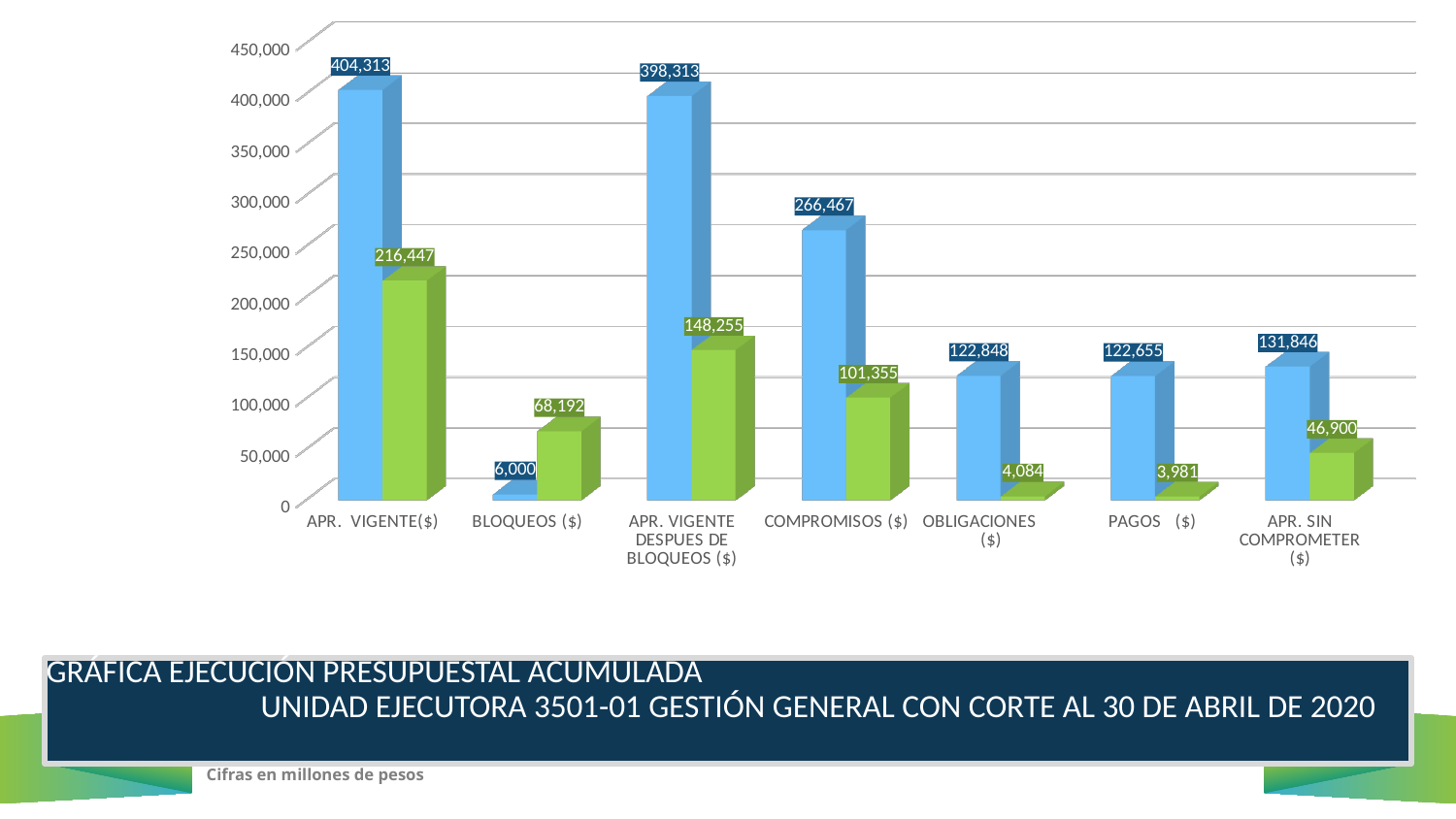
Which category has the lowest green bar? PAGOS ($) What is the value of the blue bar for COMPROMISOS ($)? 266,467 What is the value of the blue bar for APR. VIGENTE($)? 404,313 What is the value of the green bar for BLOQUEOS ($)? 68,192 How many categories are shown on the x axis? 7 What is the difference between the blue bar for OBLIGACIONES ($) and the blue bar for PAGOS ($)? 193 What is the title of the chart shown on the slide? GRÁFICA EJECUCIÓN PRESUPUESTAL ACUMULADA UNIDAD EJECUTORA 3501-01 GESTIÓN GENERAL CON CORTE AL 30 DE ABRIL DE 2020 What kind of chart is shown on the slide? Bar chart Which is larger: the blue bar for OBLIGACIONES ($) or the blue bar for APR. SIN COMPROMETER ($)? APR. SIN COMPROMETER ($) What is the difference between the blue bar and the green bar for APR. VIGENTE DESPUES DE BLOQUEOS ($)? 250,058 Which category has the highest blue bar? APR. VIGENTE($) What is the value of the green bar for APR. SIN COMPROMETER ($)? 46,900